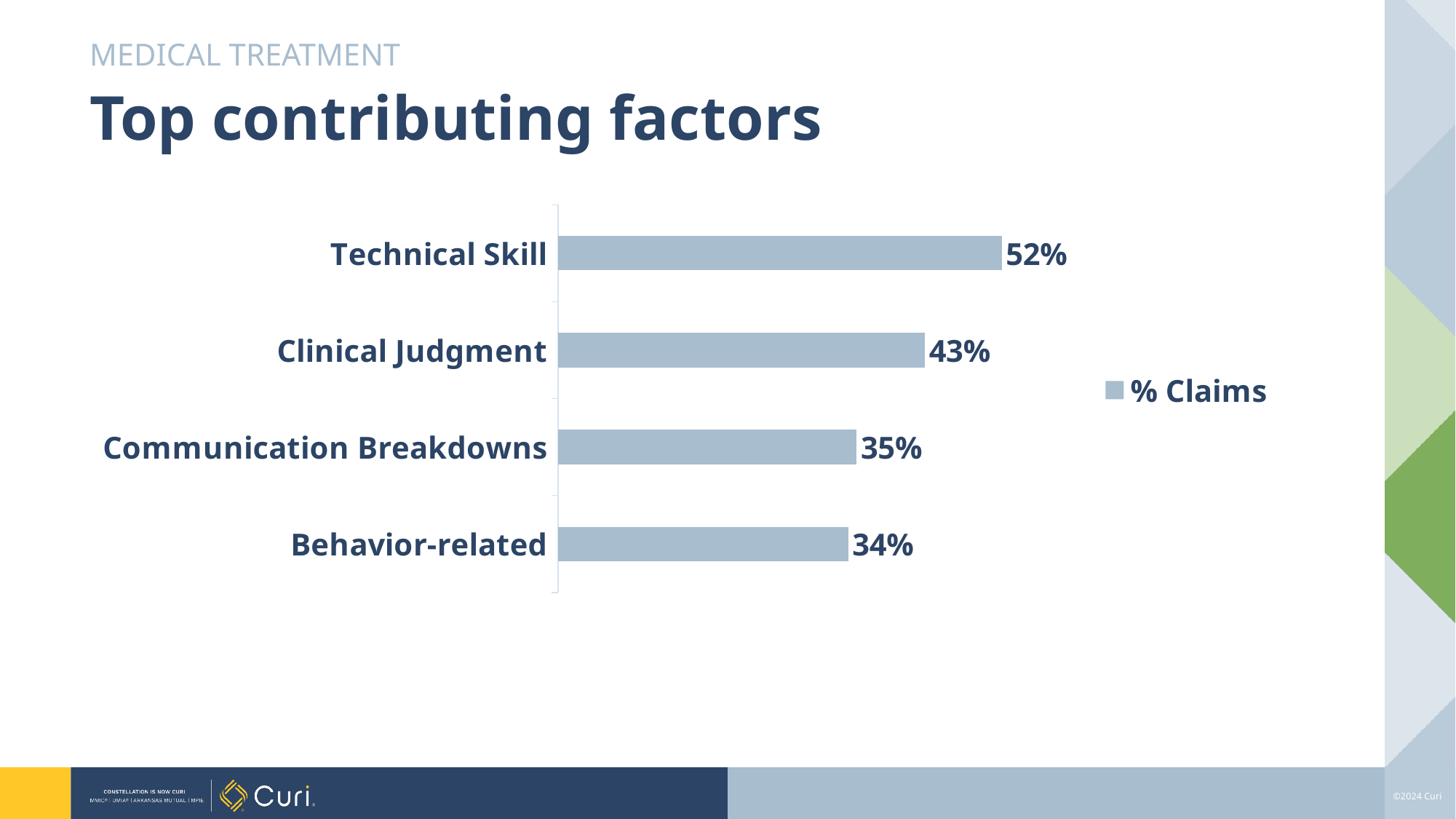
Which has a larger % Claims value, Clinical Judgment or Communication Breakdowns? Clinical Judgment What is the % Claims value for Behavior-related? 34% What is the % Claims value for Communication Breakdowns? 35% What is the difference in % Claims between Technical Skill and Clinical Judgment? 9% What is the difference in % Claims between Communication Breakdowns and Behavior-related? 1% Which contributing factor has the highest % Claims? Technical Skill How many series does the legend list? 1 How many contributing factors are shown in the chart? 4 What is the % Claims value for Clinical Judgment? 43% What is the % Claims value for Technical Skill? 52% What kind of chart is shown on the slide? Bar chart Which contributing factor has the lowest % Claims? Behavior-related